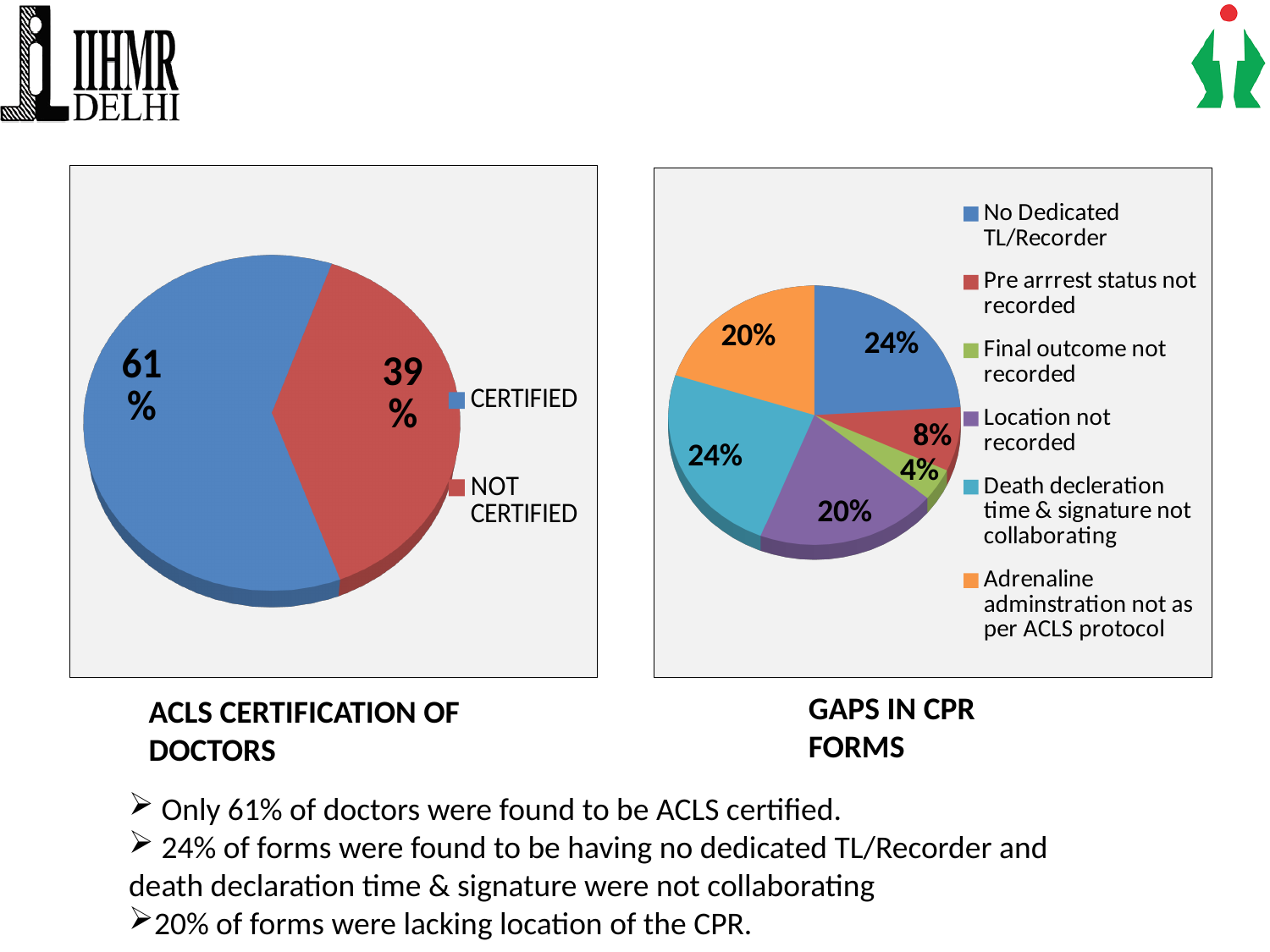
In the 'GAPS IN CPR FORMS' chart, which is larger, 'Pre arrrest status not recorded' or 'Adrenaline adminstration not as per ACLS protocol'? Adrenaline adminstration not as per ACLS protocol In the 'ACLS CERTIFICATION OF DOCTORS' chart, what percentage of doctors are not certified? 39% In the 'ACLS CERTIFICATION OF DOCTORS' chart, which slice is larger, CERTIFIED or NOT CERTIFIED? CERTIFIED How many categories does the legend of the 'GAPS IN CPR FORMS' chart list? 6 In the 'ACLS CERTIFICATION OF DOCTORS' chart, what is the difference between the certified and not certified shares? 22% What type of chart is the 'ACLS CERTIFICATION OF DOCTORS' chart? Pie chart In the 'ACLS CERTIFICATION OF DOCTORS' chart, what percentage of doctors are certified? 61% In the 'GAPS IN CPR FORMS' chart, which category has the smallest share? Final outcome not recorded In the 'GAPS IN CPR FORMS' chart, what percentage is shown for 'No Dedicated TL/Recorder'? 24% In the 'GAPS IN CPR FORMS' chart, what percentage is shown for 'Location not recorded'? 20% In the 'GAPS IN CPR FORMS' chart, what percentage is shown for 'Pre arrrest status not recorded'? 8% In the 'GAPS IN CPR FORMS' chart, what colour is the slice for 'Death decleration time & signature not collaborating'? Teal